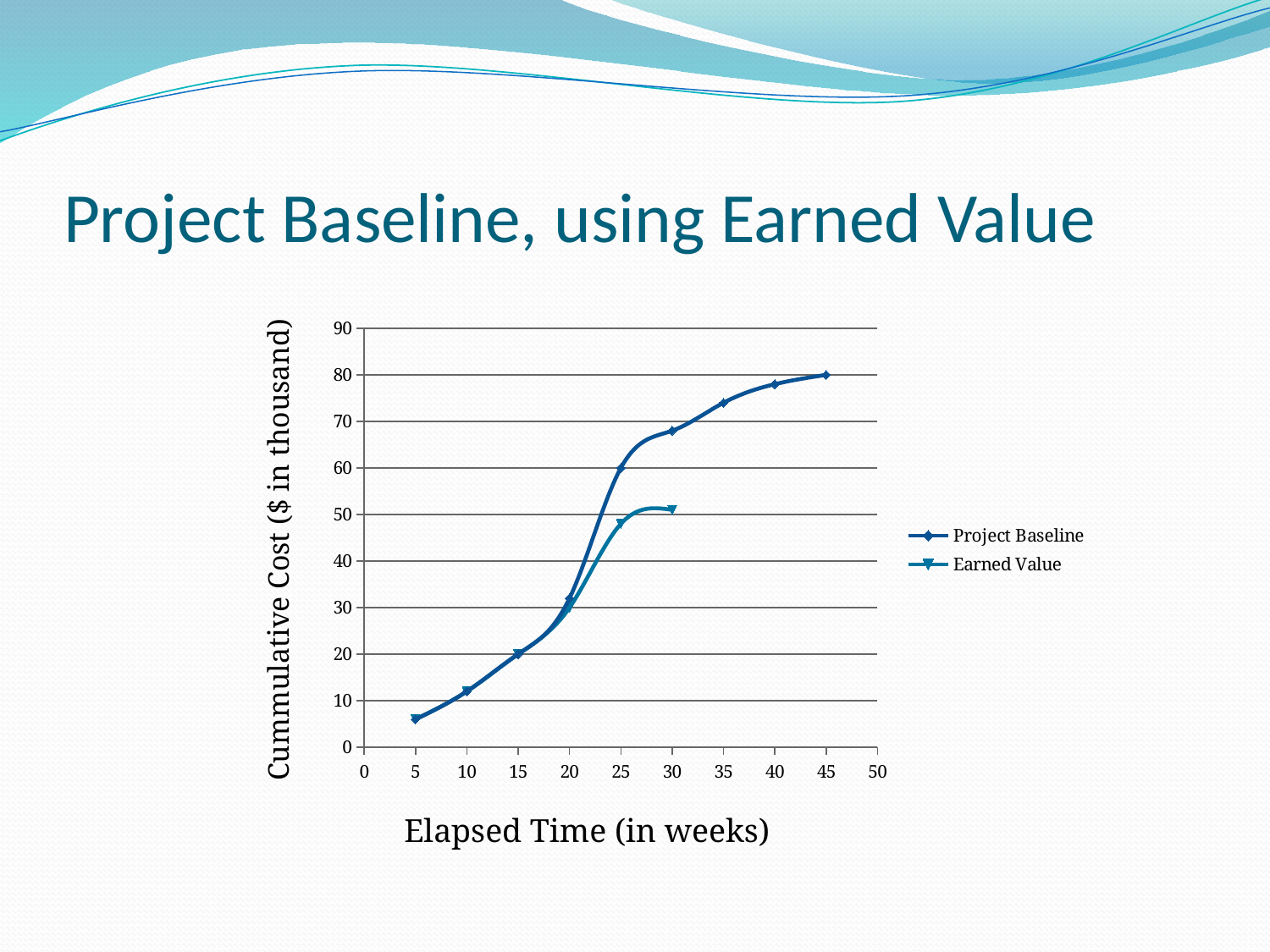
At 25 weeks, which series has the higher value, Project Baseline or Earned Value? Project Baseline Is the Earned Value at 25 weeks greater or less than 40? greater Is the Earned Value at 30 weeks greater or less than 60? less Is the Project Baseline value at 30 weeks greater or less than 60? greater What kind of chart is shown on the slide? line chart At which elapsed time does the Project Baseline series reach its highest value? 45 weeks What are the two series named in the legend? Project Baseline and Earned Value How many data points are plotted for the Earned Value series? 6 What is the title of the x axis? Elapsed Time (in weeks) Does the Project Baseline series rise or fall as elapsed time increases? rise How many series does the legend list? 2